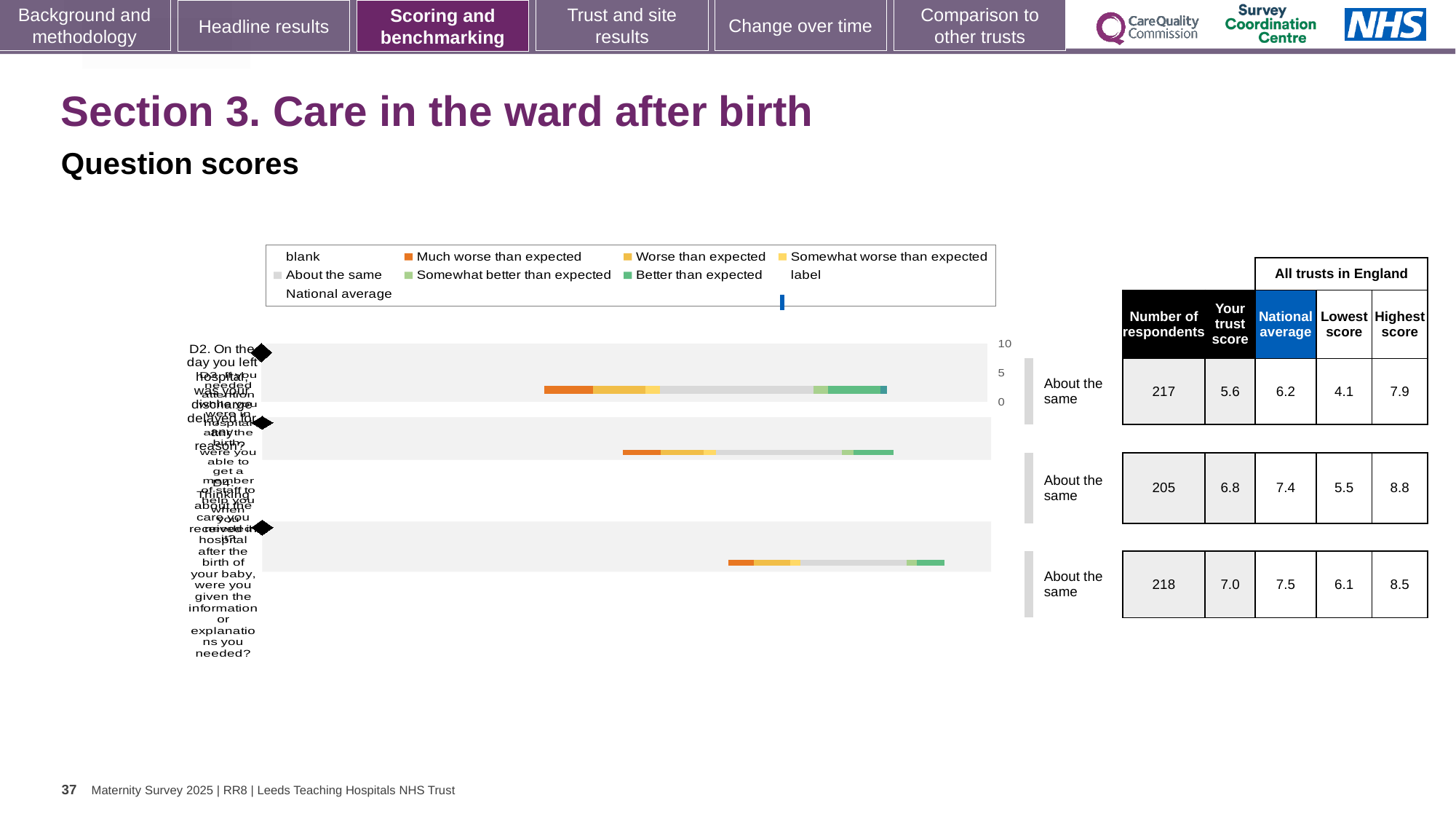
In the table beside the chart, what is the 'Your trust score' for the top row? 5.6 In the table beside the chart, what is the Highest score for the bottom row? 8.5 How many stacked bars are plotted in the chart? 3 In the table beside the chart, which row has the highest 'Your trust score'? the bottom row (7.0) Which legend entry is shown in dark orange? Much worse than expected In the table beside the chart, is the Lowest score for the bottom row larger or smaller than the Lowest score for the top row? larger In the table beside the chart, what is the Number of respondents for the middle row? 205 What benchmark category label is shown beside the top bar of the chart? About the same In the table beside the chart, what is the difference between the National average and Your trust score for the top row? 0.6 In the table beside the chart, what is the National average for the middle row? 7.4 What kind of chart is shown on the slide? bar chart